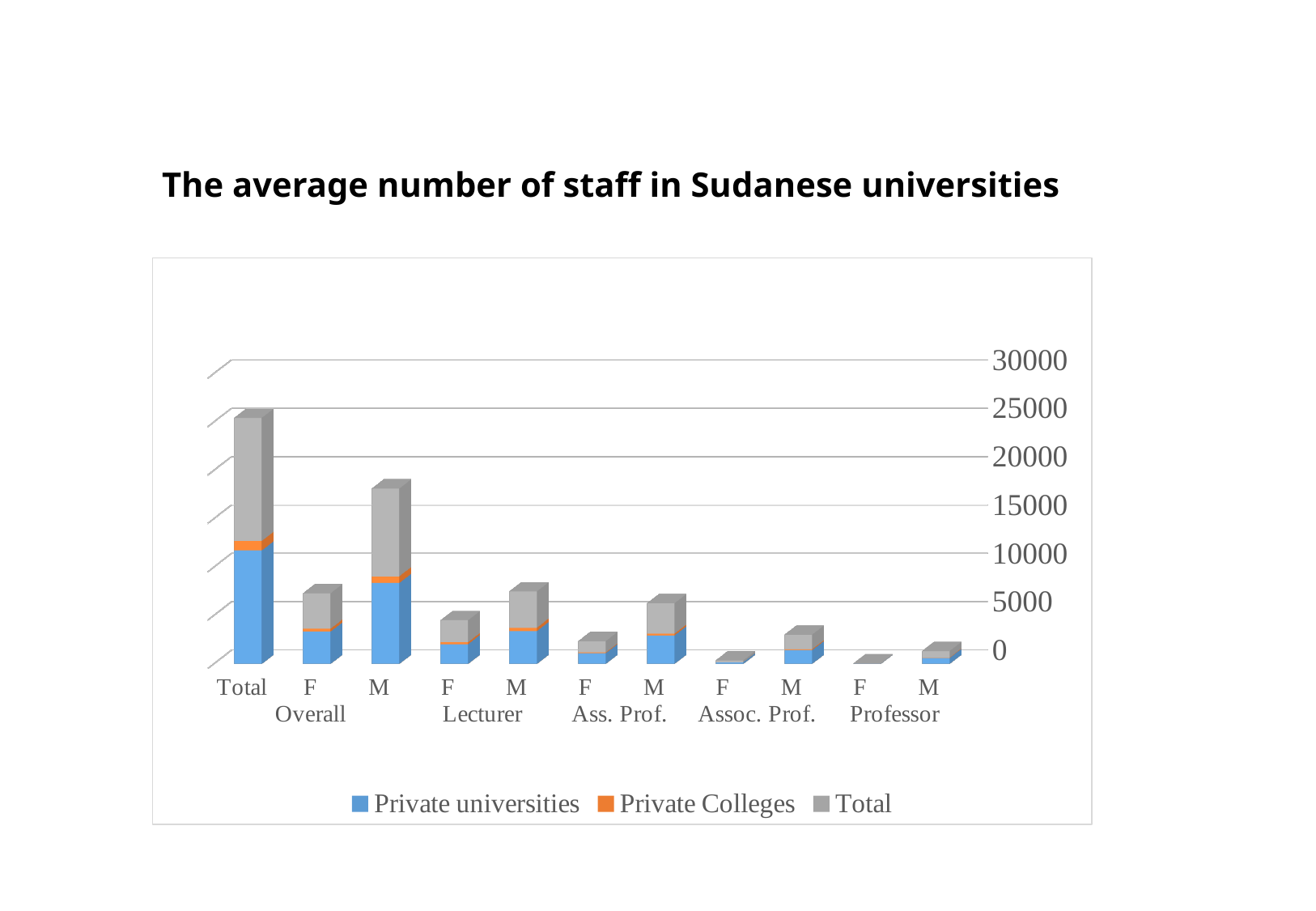
What kind of chart is shown on the slide? Stacked bar chart Which bar is taller, M Overall or F Overall? M Overall Is the stacked value for F Overall greater or less than 10000? less Which bar is taller, M Lecturer or F Lecturer? M Lecturer Is the stacked value for the Total bar greater or less than 20000? greater How many bars are plotted in the chart? 11 How many series does the legend list? 3 What is the title of the chart? The average number of staff in Sudanese universities Is the stacked value for M Overall greater or less than 15000? greater Which bar reaches the highest value in the chart? Total Which series is shown in orange in the legend? Private Colleges